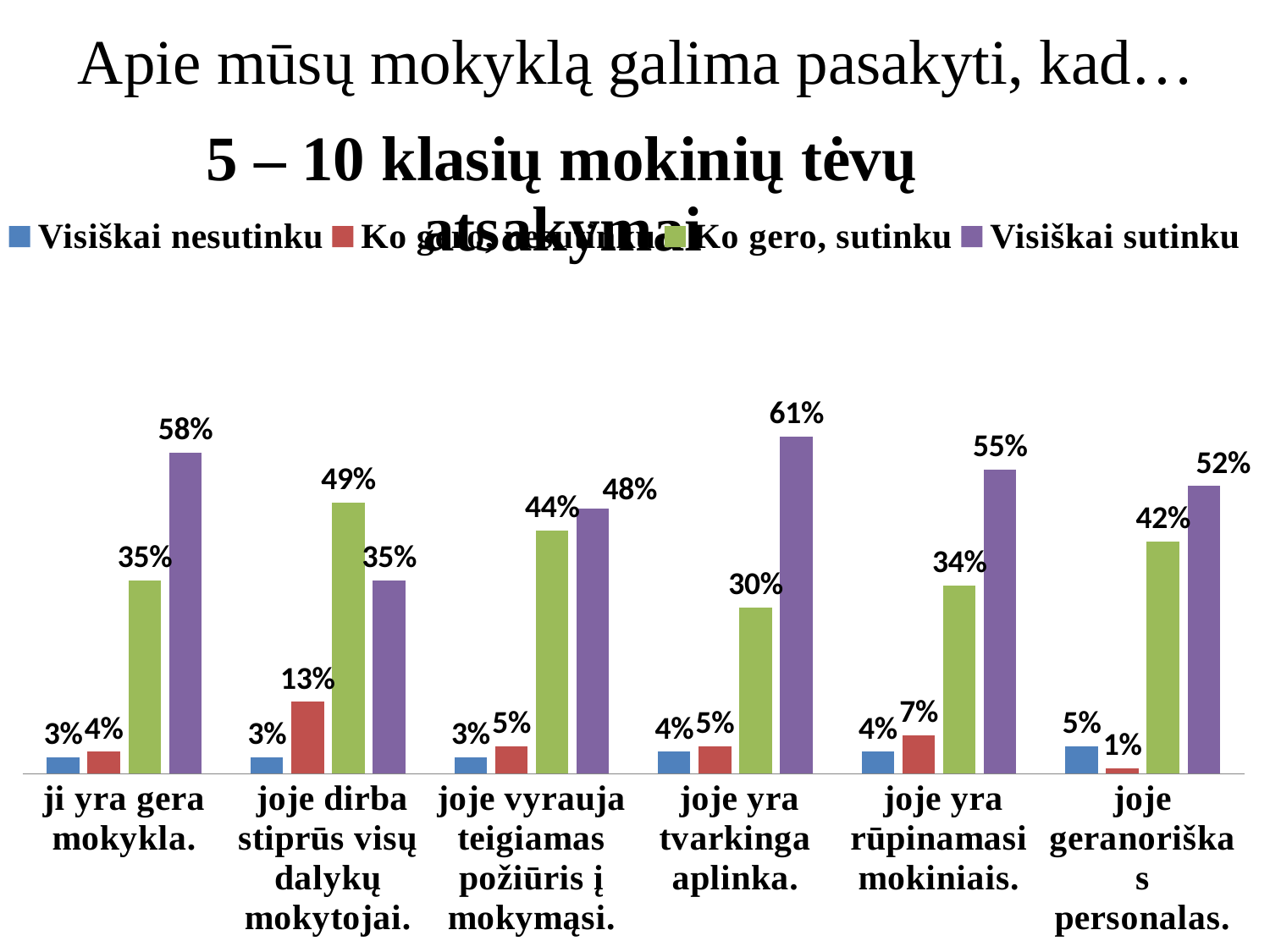
How many series does the legend list? 4 How many categories are shown on the x axis? 6 What kind of chart is shown on the slide? bar chart Which category has the lowest "Visiškai sutinku" value? joje dirba stiprūs visų dalykų mokytojai. What is the difference between the "Visiškai sutinku" and "Ko gero, sutinku" values for "joje yra tvarkinga aplinka."? 31% What is the "Visiškai sutinku" value for "ji yra gera mokykla."? 58% Which category has the highest "Visiškai sutinku" value? joje yra tvarkinga aplinka. What is the "Visiškai nesutinku" value for "joje geranoriškas personalas."? 5% What colour are the "Visiškai sutinku" bars? purple For "joje dirba stiprūs visų dalykų mokytojai.", which is larger: "Ko gero, sutinku" or "Visiškai sutinku"? Ko gero, sutinku What is the "Ko gero, sutinku" value for "joje dirba stiprūs visų dalykų mokytojai."? 49% What is the "Ko gero, sutinku" value for "joje yra rūpinamasi mokiniais."? 34%